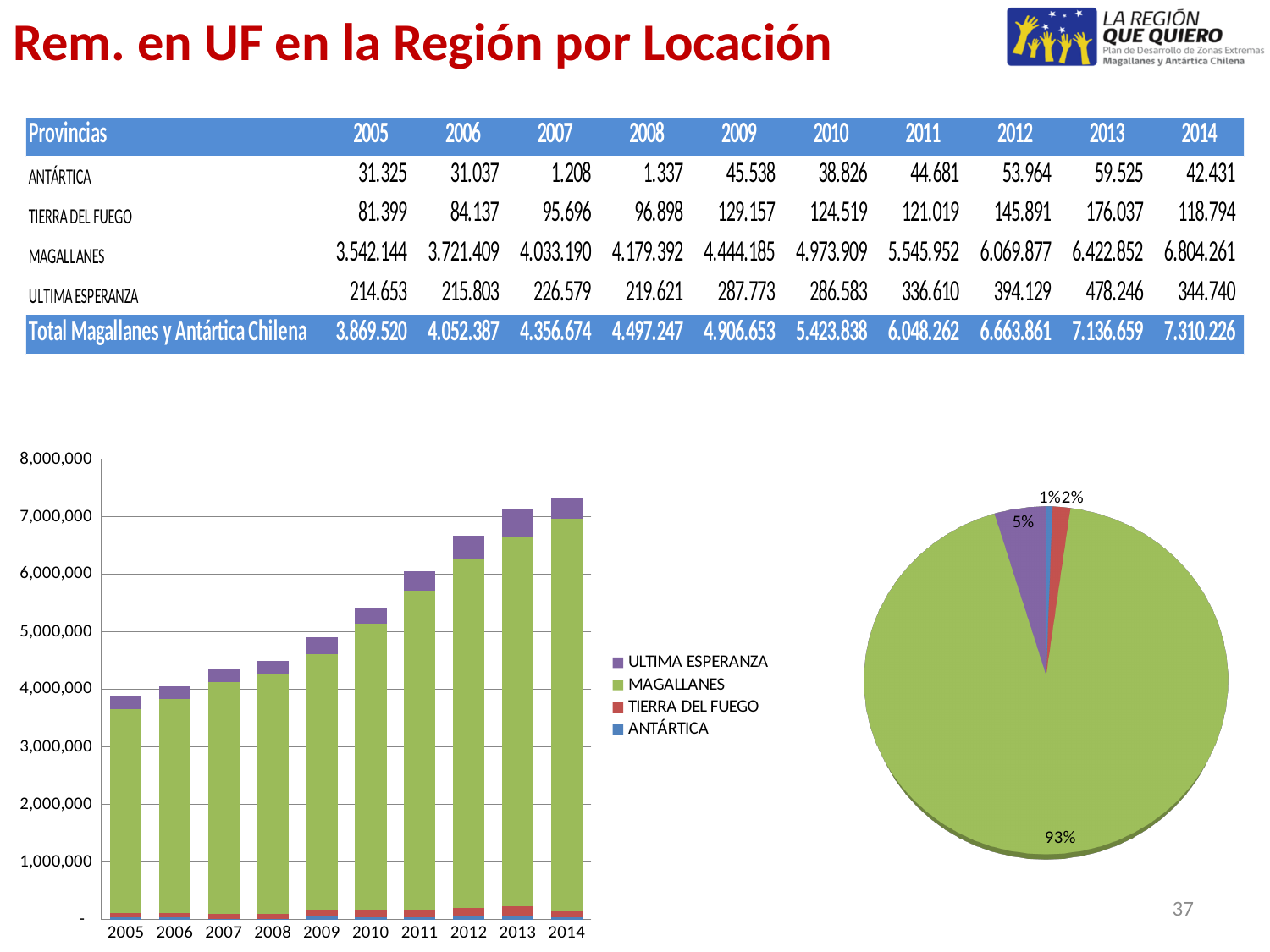
In the pie chart, what share does the Ultima Esperanza slice (purple) have? 5% In the bar chart, which series is shown in green? MAGALLANES In the pie chart, what share does the Magallanes slice (green) have? 93% What type of chart is shown on the left of the slide? stacked bar chart In the bar chart, which year has the highest total stacked bar? 2014 In the bar chart, do the total stacked bars rise or fall from 2005 to 2014? rise In the bar chart, which year has the lowest total stacked bar? 2005 How many years are shown on the x axis of the bar chart? 10 In the bar chart, is the total stacked bar for 2005 greater or less than 4,000,000? less In the bar chart, is the total stacked bar for 2014 greater or less than 7,000,000? greater What type of chart is shown on the right of the slide? pie chart How many series does the legend of the bar chart list? 4